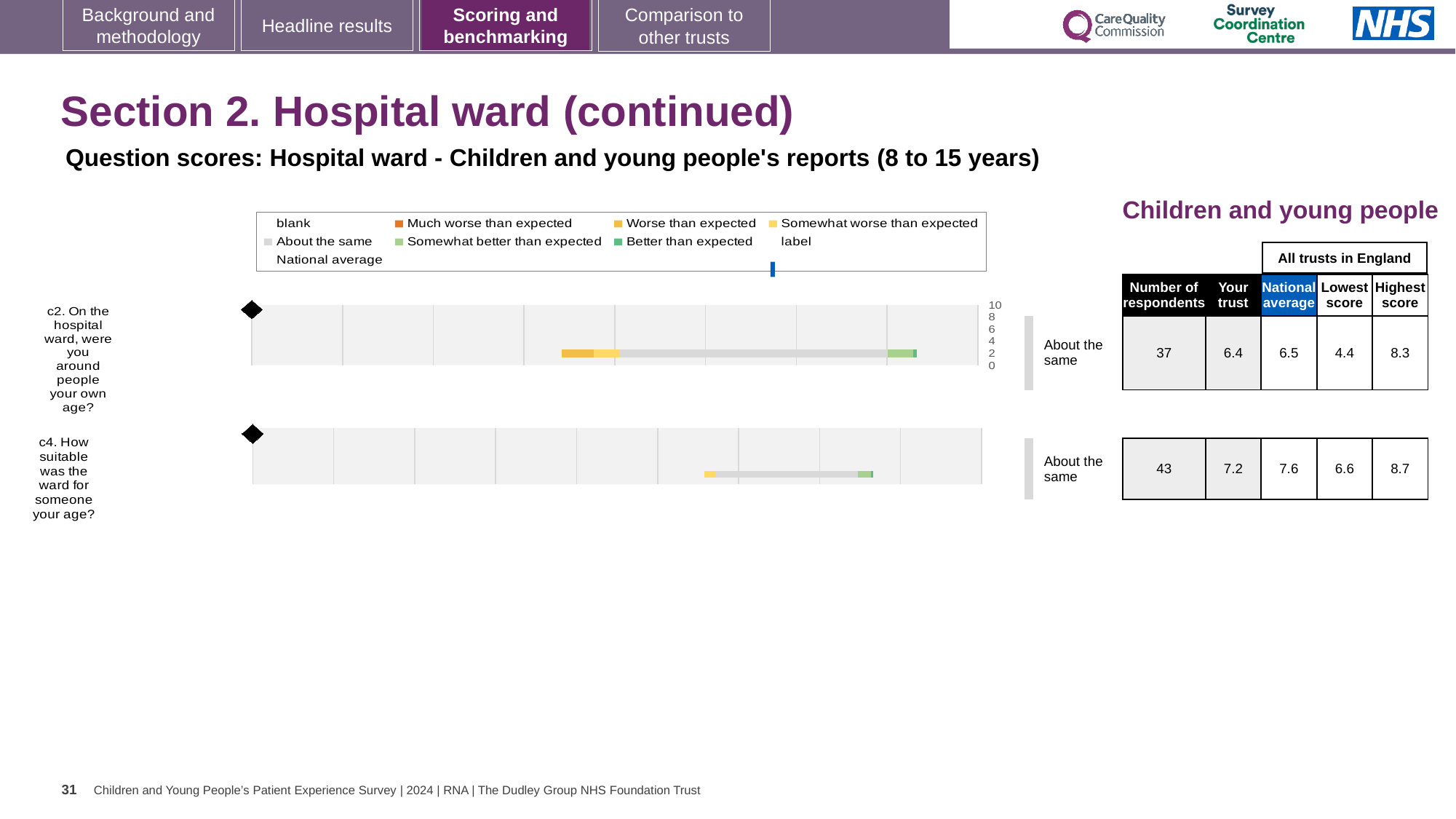
Which question has more respondents, c2 or c4? c4 How many questions are plotted on the slide? 2 What benchmark category is shown for question c2? About the same What is the lowest score among all trusts in England for question c2? 4.4 What is the 'Your trust' score for question c2 (On the hospital ward, were you around people your own age?)? 6.4 How many respondents answered question c2? 37 What is the national average score for question c4 (How suitable was the ward for someone your age?)? 7.6 For question c2, what is the difference between the highest and lowest scores among all trusts in England? 3.9 For question c4, what is the difference between the national average and the 'Your trust' score? 0.4 What kind of chart is used to show the question scores? Bar chart Which question has the higher 'Your trust' score, c2 or c4? c4 What is the highest score among all trusts in England for question c4? 8.7